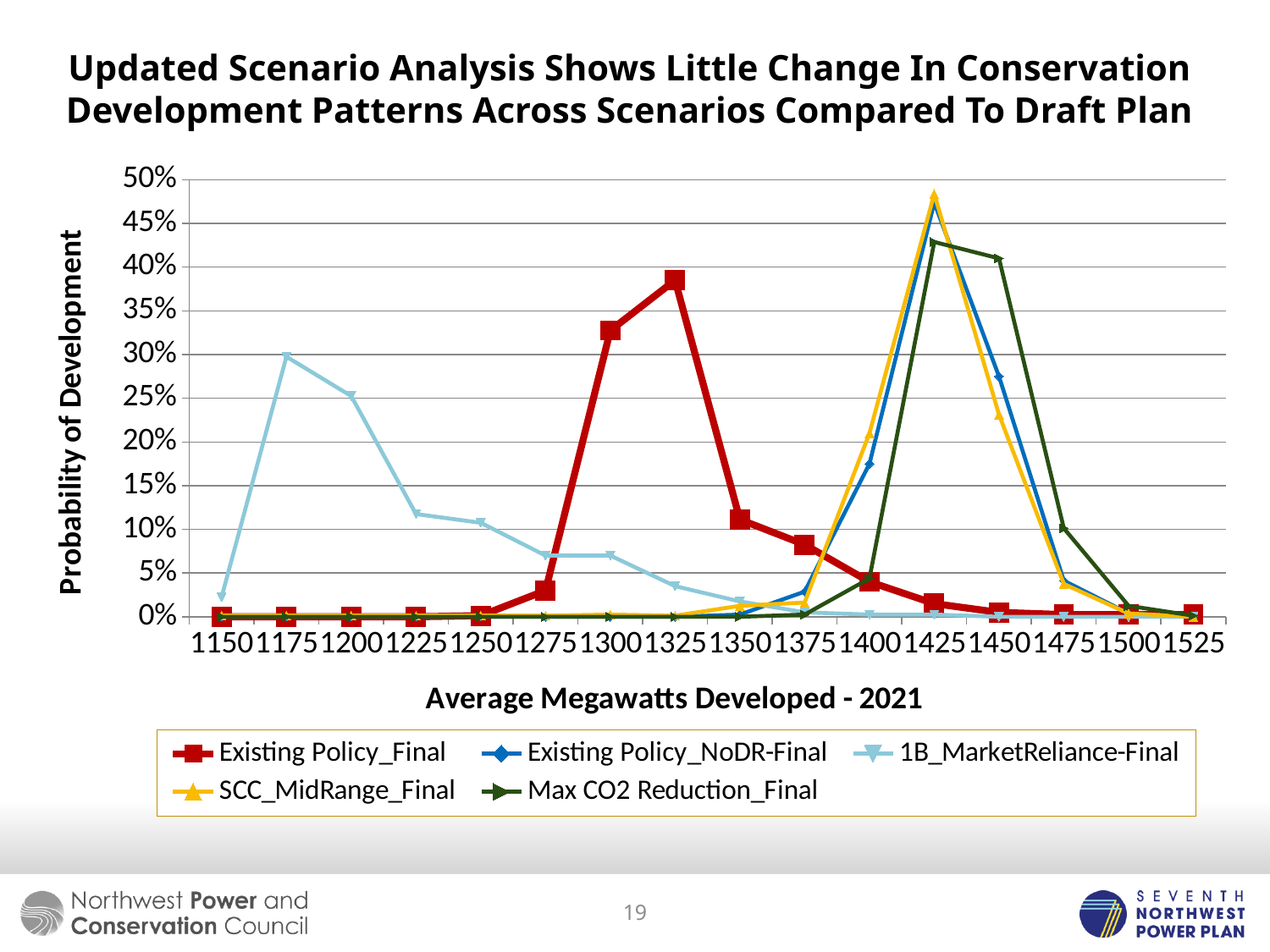
Is the value for Existing Policy_Final at 1325 greater or less than 35%? greater How many series does the legend list? 5 Does the 1B_MarketReliance-Final series rise or fall between 1175 and 1375? fall Is the value for 1B_MarketReliance-Final at 1175 greater or less than 25%? greater At which x-axis value does the 1B_MarketReliance-Final series reach its highest point? 1175 At 1450, which series has the higher value: Max CO2 Reduction_Final or SCC_MidRange_Final? Max CO2 Reduction_Final How many x-axis values are plotted along the horizontal axis? 16 Is the value for Max CO2 Reduction_Final at 1475 greater or less than 15%? less At 1400, which series has the higher value: Existing Policy_NoDR-Final or Existing Policy_Final? Existing Policy_NoDR-Final What is the title of the vertical axis? Probability of Development At which x-axis value does the Existing Policy_Final series reach its highest point? 1325 What kind of chart is shown on the slide? line chart